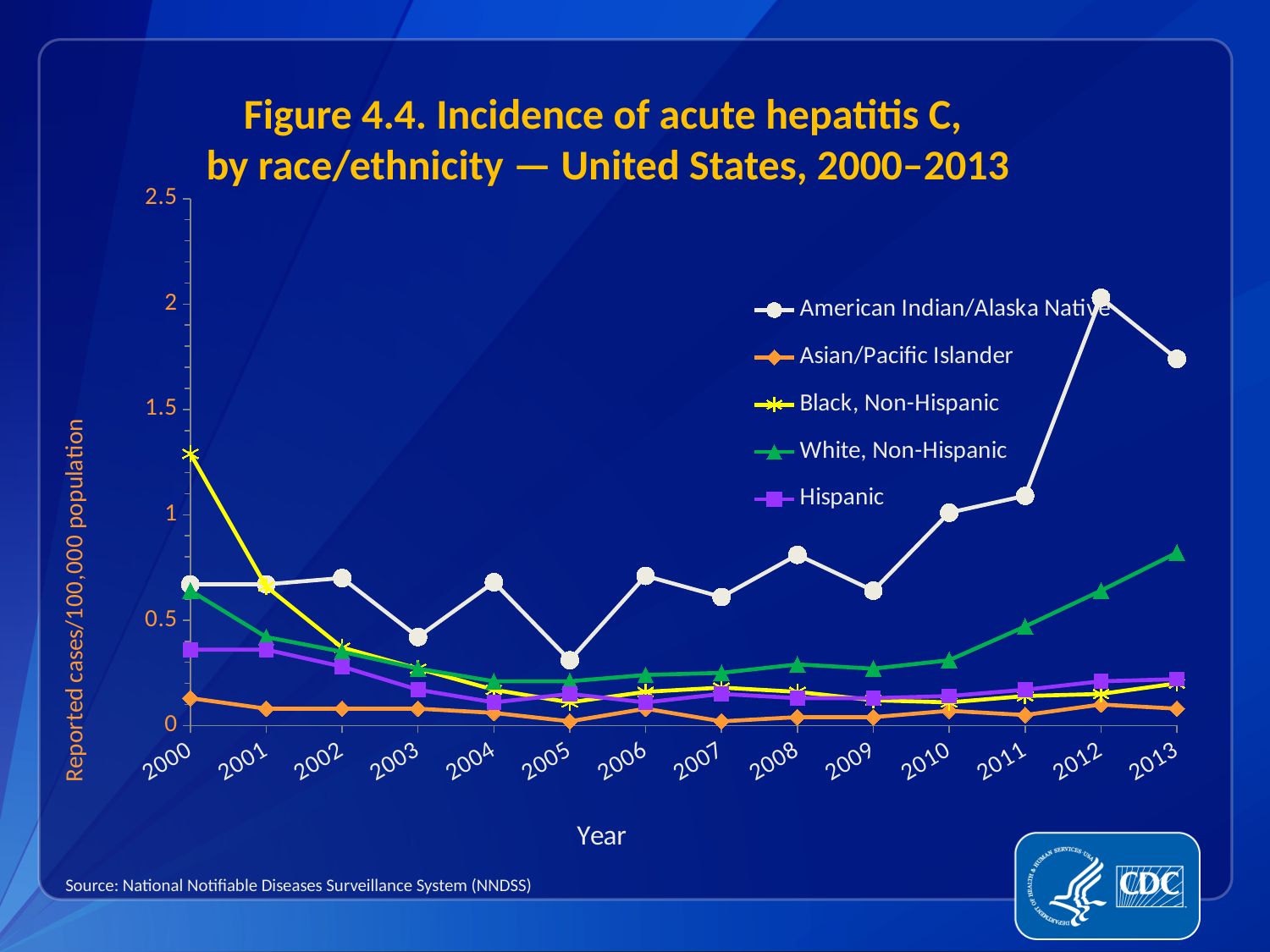
What kind of chart is shown on the slide? line chart In 2000, which is higher: Black, Non-Hispanic or White, Non-Hispanic? Black, Non-Hispanic Is the value for Black, Non-Hispanic in 2000 greater or less than 1? greater Which race/ethnicity group has the highest incidence in 2013? American Indian/Alaska Native In 2013, which is higher: White, Non-Hispanic or Hispanic? White, Non-Hispanic Is the value for American Indian/Alaska Native in 2012 greater or less than 1.5? greater How many series does the legend list? 5 Which race/ethnicity group has the lowest incidence in 2013? Asian/Pacific Islander Does the White, Non-Hispanic line rise or fall from 2009 to 2013? rise What is the label on the y axis? Reported cases/100,000 population Is the value for White, Non-Hispanic in 2013 greater or less than 1? less How many years are plotted along the x axis? 14